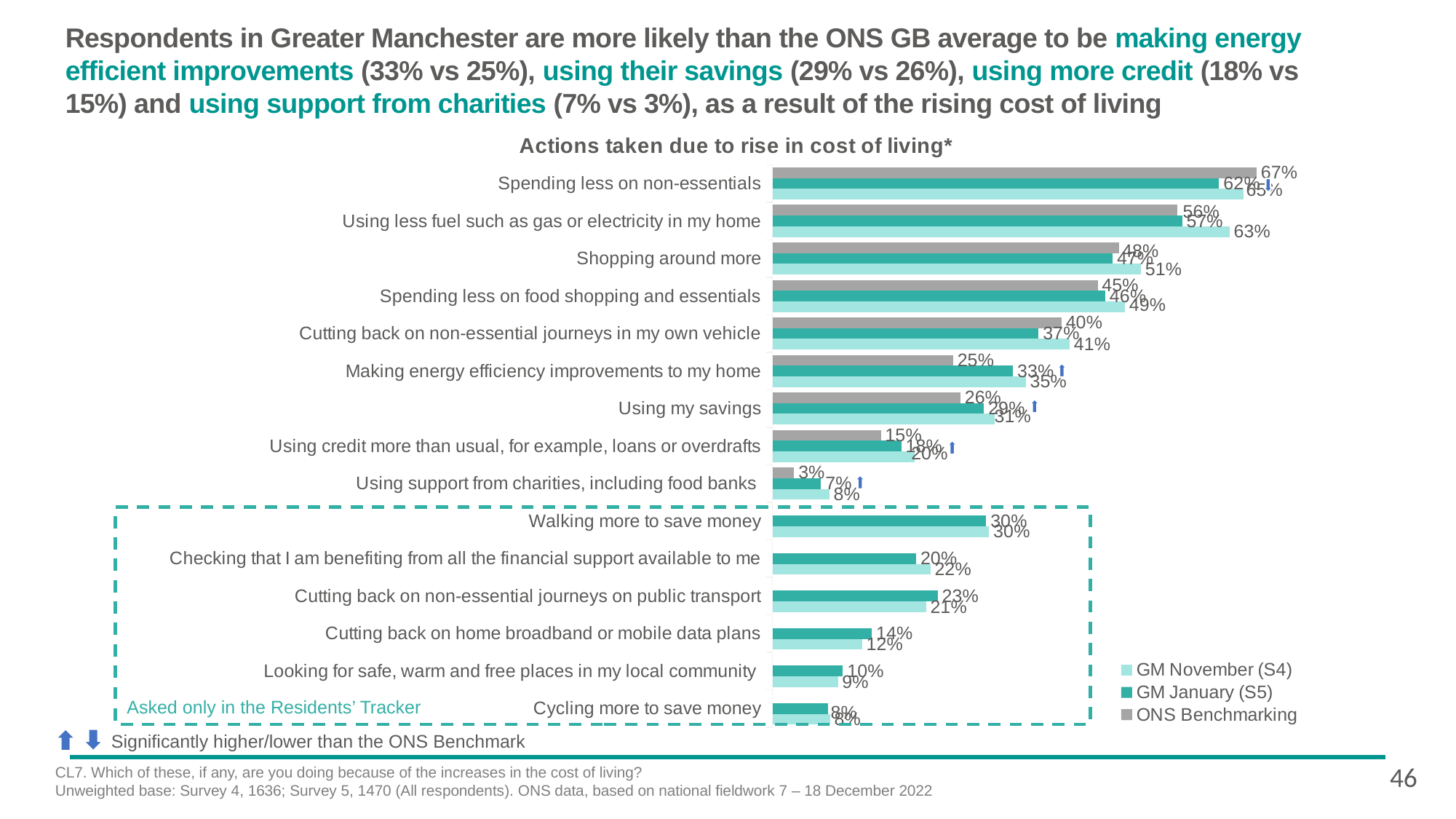
What type of chart is shown on the slide? bar chart What is the ONS Benchmarking value for 'Using support from charities, including food banks'? 3% What is the GM November (S4) value for 'Using less fuel such as gas or electricity in my home'? 63% Which action has the lowest ONS Benchmarking value? Using support from charities, including food banks What is the ONS Benchmarking value for 'Spending less on non-essentials'? 67% For 'Cutting back on non-essential journeys on public transport', which is larger: the GM January (S5) value or the GM November (S4) value? GM January (S5) Which action has the highest GM January (S5) value? Spending less on non-essentials How many series does the legend list? 3 How many actions are listed on the chart? 15 What is the difference between the GM January (S5) and ONS Benchmarking values for 'Using credit more than usual, for example, loans or overdrafts'? 3% What is the GM January (S5) value for 'Making energy efficiency improvements to my home'? 33% What is the title of the chart? Actions taken due to rise in cost of living*